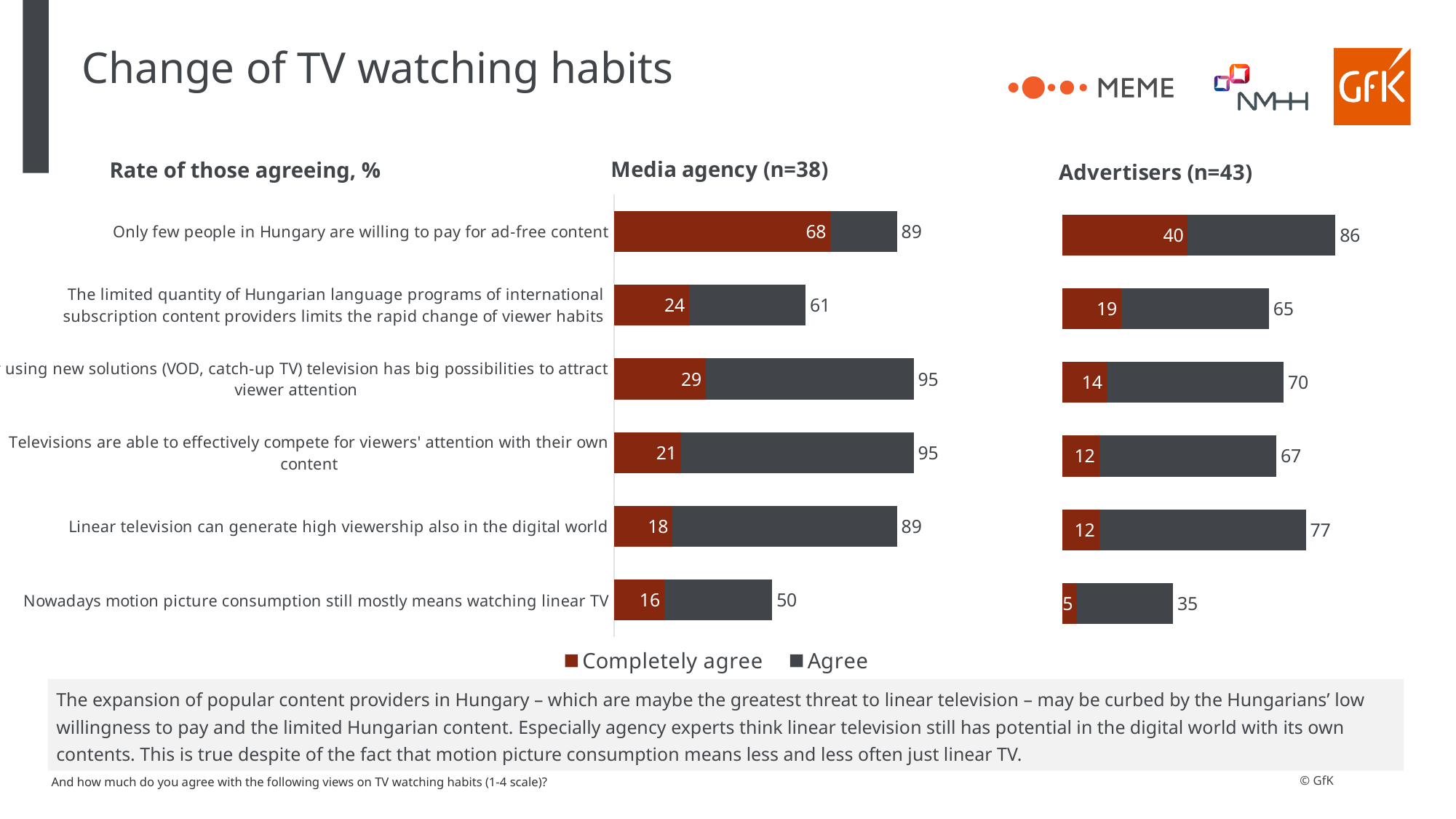
How many statements are shown in the Media agency (n=38) chart? 6 In the Media agency (n=38) chart, which statement has the highest 'Completely agree' value? Only few people in Hungary are willing to pay for ad-free content What is the difference between the Media agency and Advertisers total rates of agreement for 'Televisions are able to effectively compete for viewers' attention with their own content'? 28 Which colour represents 'Completely agree' in the legend? Dark red In the Advertisers (n=43) chart, what is the total rate of those agreeing with 'Linear television can generate high viewership also in the digital world'? 77 What type of chart is used to show the Advertisers (n=43) data? Stacked bar chart In the Advertisers (n=43) chart, which statement has the highest total rate of those agreeing? Only few people in Hungary are willing to pay for ad-free content Which group has a higher total rate of agreement with 'Nowadays motion picture consumption still mostly means watching linear TV', Media agency or Advertisers? Media agency In the Media agency (n=38) chart, which statement has the lowest total rate of those agreeing? Nowadays motion picture consumption still mostly means watching linear TV How many series does the legend list? 2 In the Media agency (n=38) chart, what is the 'Completely agree' value for 'Only few people in Hungary are willing to pay for ad-free content'? 68 In the Advertisers (n=43) chart, what is the 'Completely agree' value for 'Nowadays motion picture consumption still mostly means watching linear TV'? 5